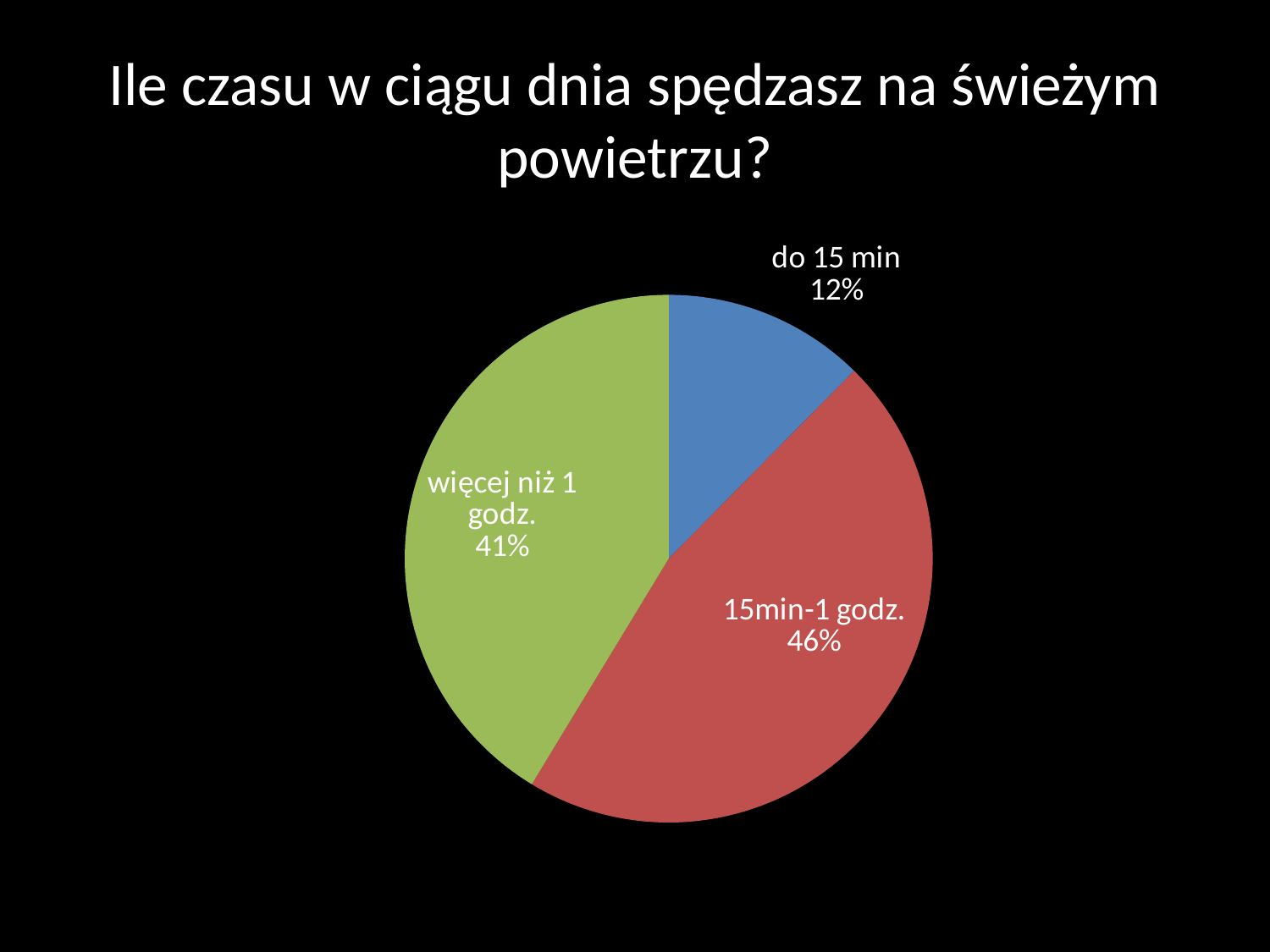
What kind of chart is shown on the slide? pie chart Which is larger: the 'do 15 min' slice or the 'więcej niż 1 godz.' slice? więcej niż 1 godz. Which category has the smallest slice of the pie? do 15 min What share of the pie does the 'do 15 min' slice represent? 12% What colour is the '15min-1 godz.' slice? red How many slices does the pie chart have? 3 What is the difference in percentage points between the 'więcej niż 1 godz.' slice and the 'do 15 min' slice? 29 What is the difference in percentage points between the '15min-1 godz.' slice and the 'więcej niż 1 godz.' slice? 5 What share of the pie does the '15min-1 godz.' slice represent? 46% Which category has the largest slice of the pie? 15min-1 godz. What is the title of the chart? Ile czasu w ciągu dnia spędzasz na świeżym powietrzu? What share of the pie does the 'więcej niż 1 godz.' slice represent? 41%